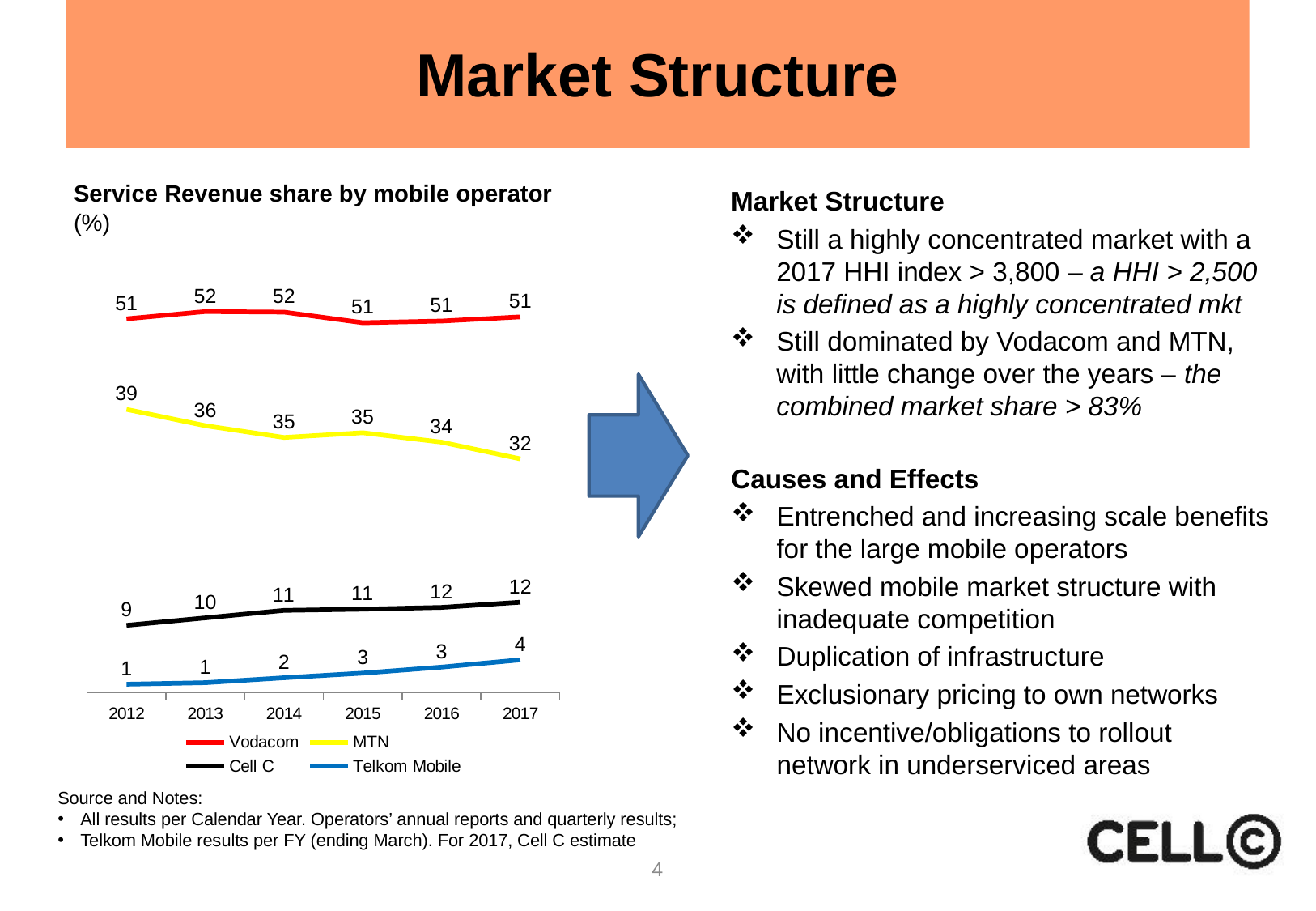
What is the difference between Vodacom's and MTN's service revenue share in 2017? 19 Does MTN's service revenue share rise or fall from 2012 to 2017? Fall Which operator has the highest service revenue share in 2017? Vodacom How many years are shown on the x axis of the chart? 6 Which operator has the lowest service revenue share in 2012? Telkom Mobile What kind of chart is used to show service revenue share by mobile operator? Line chart What is MTN's service revenue share in 2017? 32 What is Vodacom's service revenue share in 2013? 52 Which is larger in 2014: Cell C's share or Telkom Mobile's share? Cell C How many series does the chart legend list? 4 What is Cell C's service revenue share in 2012? 9 What is Telkom Mobile's service revenue share in 2016? 3